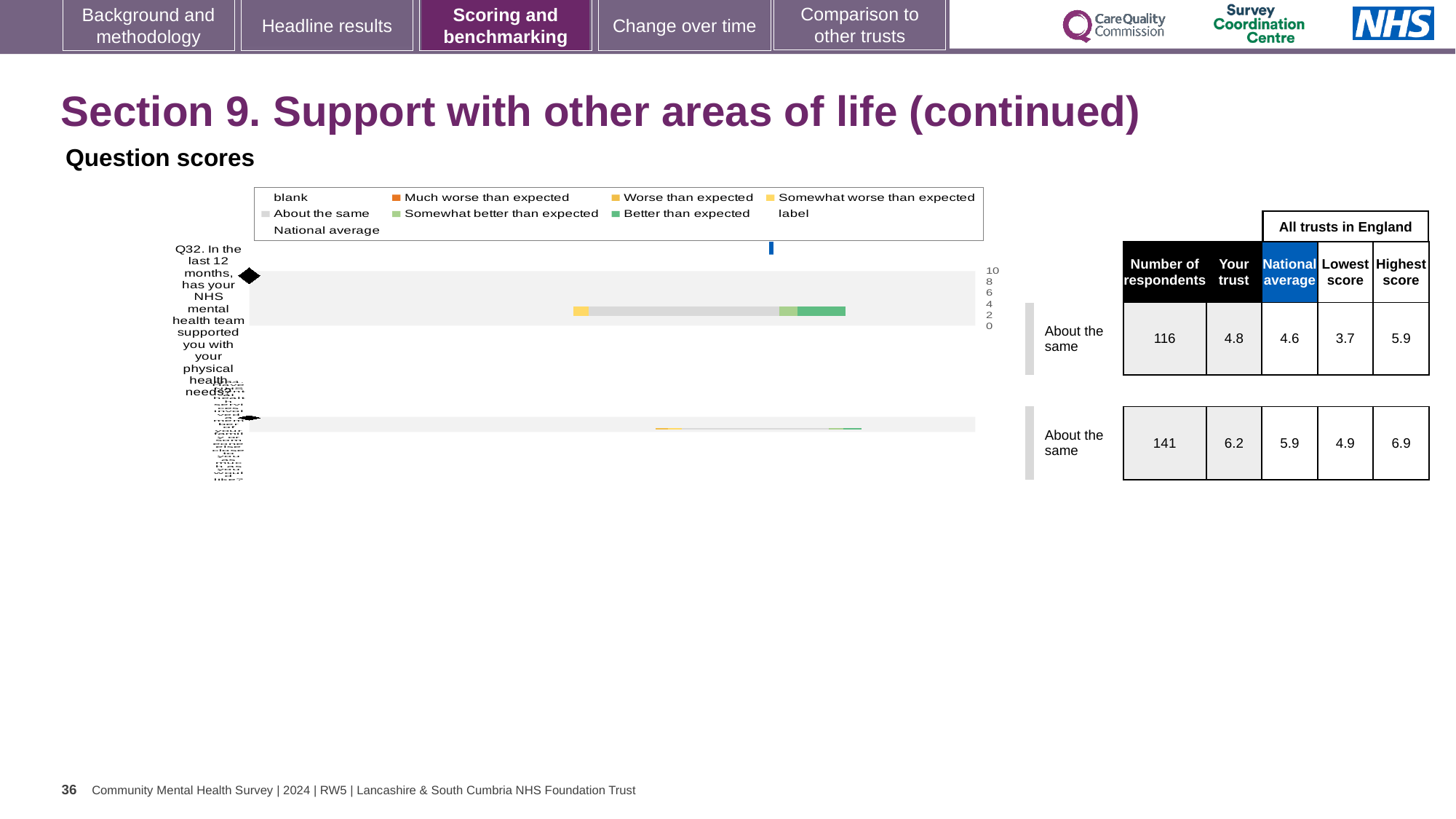
What is the 'Your trust' score for Q32 (support with physical health needs)? 4.8 How many question bars are plotted in the chart? 2 What is the national average score for Q32? 4.6 Is the trust's score for Q32 greater or less than 4? greater What is the difference between the highest and lowest trust scores for Q32? 2.2 For Q32, which is higher: the trust's score or the national average? Your trust (4.8) What kind of chart is shown on the slide? bar chart What is the lowest score among all trusts in England for Q32? 3.7 Which benchmarking category is Q32 assigned to? About the same How many respondents answered Q32? 116 By how much does the trust's score for Q32 exceed the national average? 0.2 What is the highest score among all trusts in England for Q32? 5.9